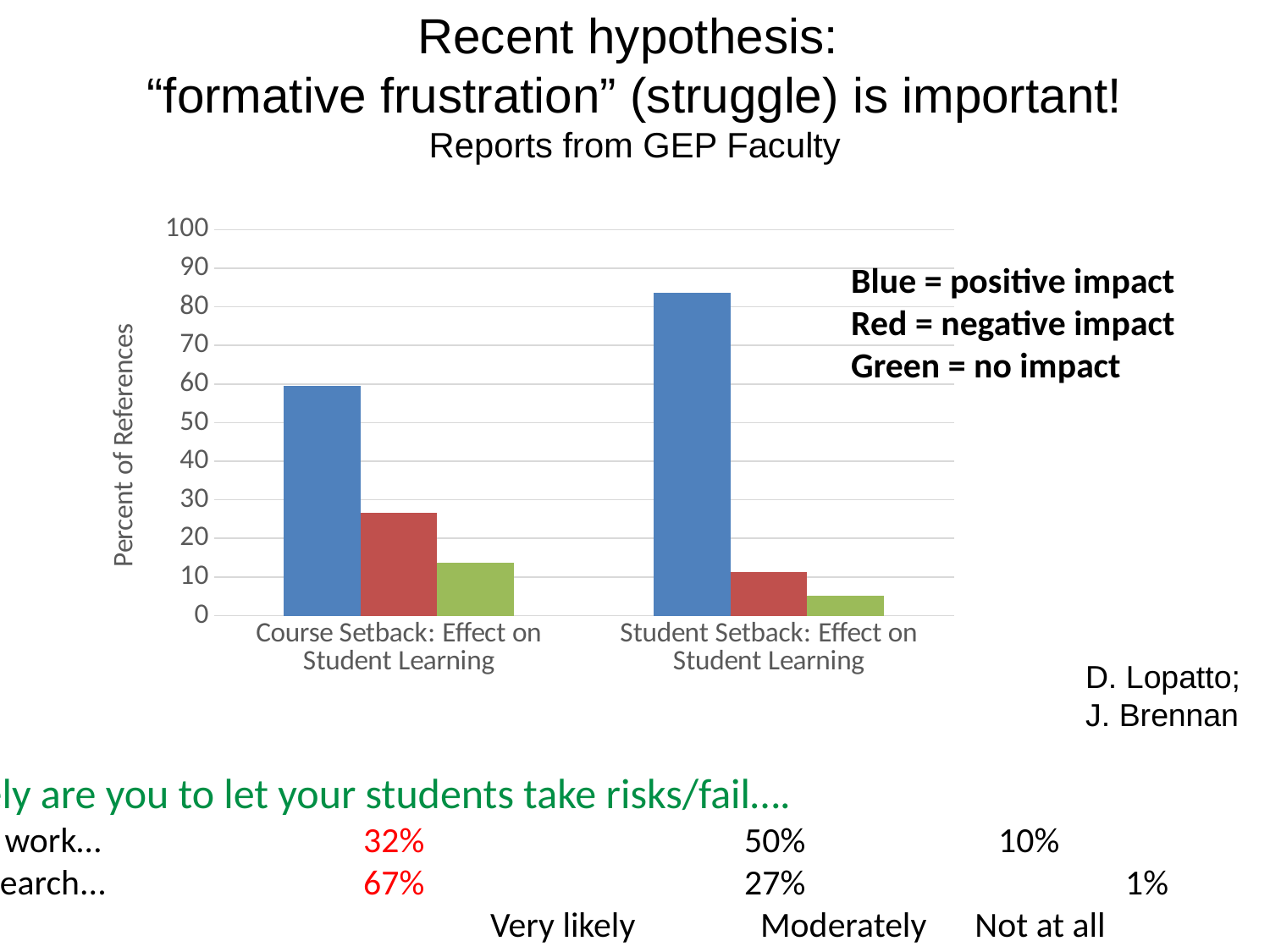
How many series (bar colours) does the key on the slide list for the chart? 3 According to the key on the slide, what does the red bar represent? negative impact Is the value of the blue (positive impact) bar for Student Setback: Effect on Student Learning greater or less than 80? greater How many categories are shown on the x axis of the chart? 2 Which bar in the chart is the tallest overall? positive impact (blue) for Student Setback: Effect on Student Learning Is the value of the blue (positive impact) bar for Course Setback: Effect on Student Learning greater or less than 50? greater Is the value of the red (negative impact) bar for Course Setback: Effect on Student Learning greater or less than 30? less What is the title of the vertical axis of the chart? Percent of References Which category has the higher red (negative impact) bar: Course Setback or Student Setback? Course Setback: Effect on Student Learning Which category has the higher blue (positive impact) bar: Course Setback or Student Setback? Student Setback: Effect on Student Learning What kind of chart is shown on the slide? bar chart